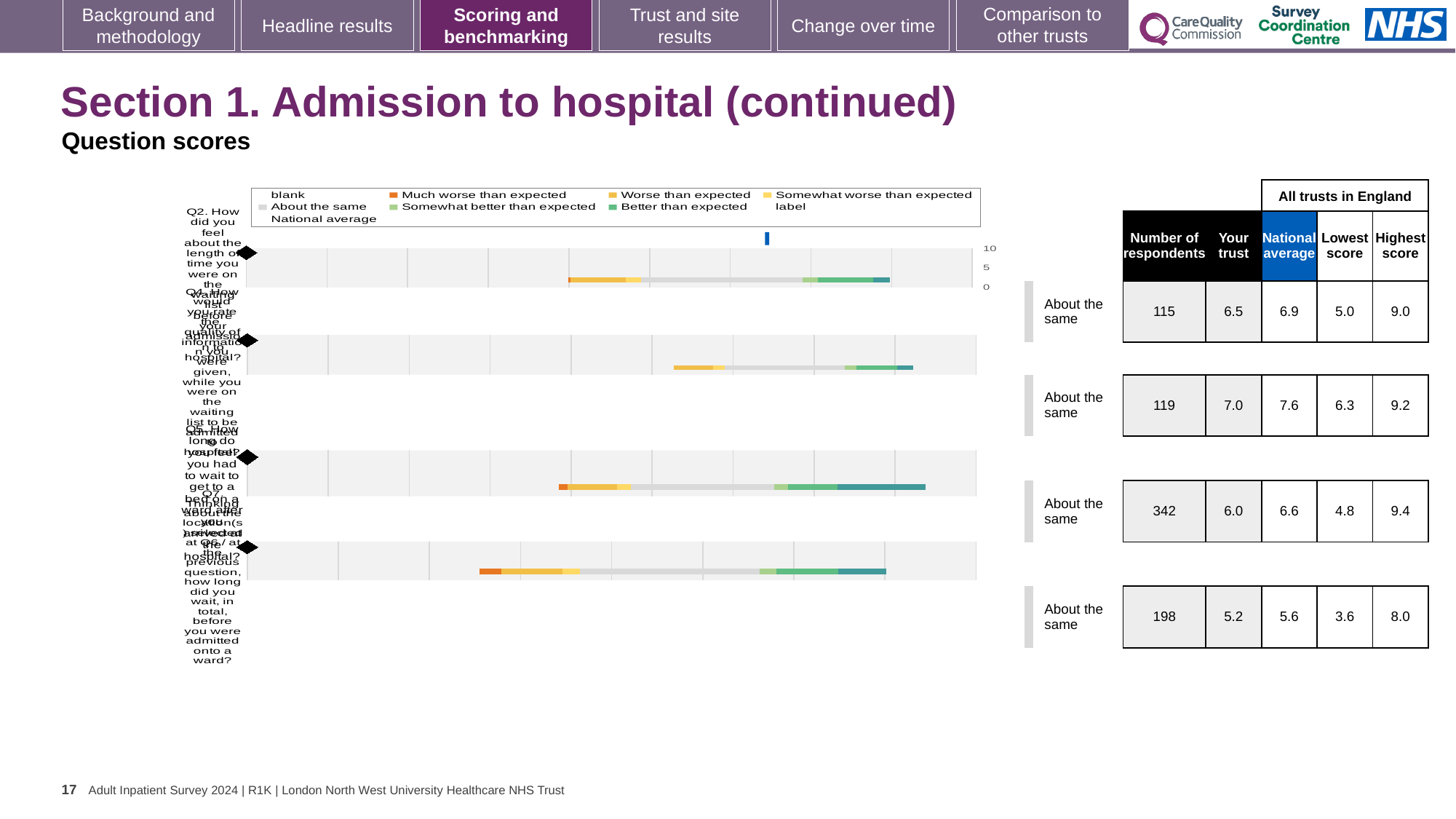
What is the difference between the highest score (9.4) and the lowest score (4.8) in the third row of the table? 4.6 How many question rows (bars) are plotted in the chart? 4 What is the highest score in England for the fourth row (198 respondents)? 8.0 Which row of the table has the highest number of respondents? the third row (342) In the second row of the table, which is larger: the 'Your trust' score or the national average? National average What kind of chart is shown on the slide? bar chart According to the legend, what does the blue marker represent? National average What is the lowest 'Your trust' score shown in the table? 5.2 In the table, what is the national average for the row with 342 respondents? 6.6 In the table, what is the 'Your trust' score for the first row (115 respondents)? 6.5 What benchmark category is shown next to each of the four questions? About the same In the first row of the table, how much higher is the national average (6.9) than the trust score (6.5)? 0.4